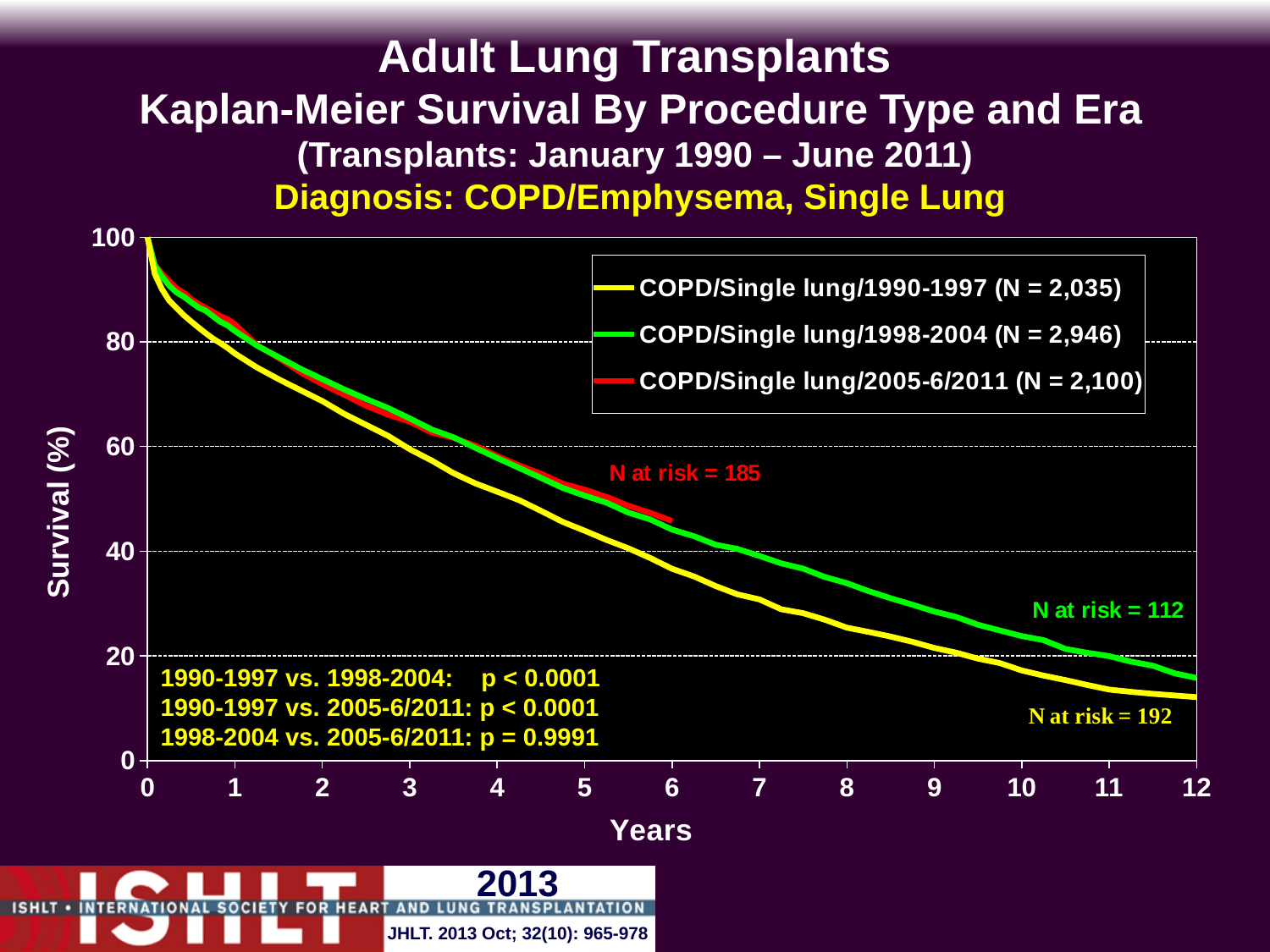
What is the N at risk shown for the 2005-6/2011 (red) curve? 185 What is the N for the COPD/Single lung/1990-1997 series in the legend? 2,035 What is the N for the COPD/Single lung/2005-6/2011 series in the legend? 2,100 Is the survival for the 1998-2004 curve at 6 years greater or less than 40? greater How many series does the legend list? 3 Do the survival curves rise or fall as years increase? fall What is the p-value for 1998-2004 vs. 2005-6/2011? p = 0.9991 What is the N for the COPD/Single lung/1998-2004 series in the legend? 2,946 What is the N at risk shown for the 1998-2004 (green) curve? 112 What kind of chart is shown on the slide? line chart At 8 years, which curve shows higher survival: 1990-1997 or 1998-2004? 1998-2004